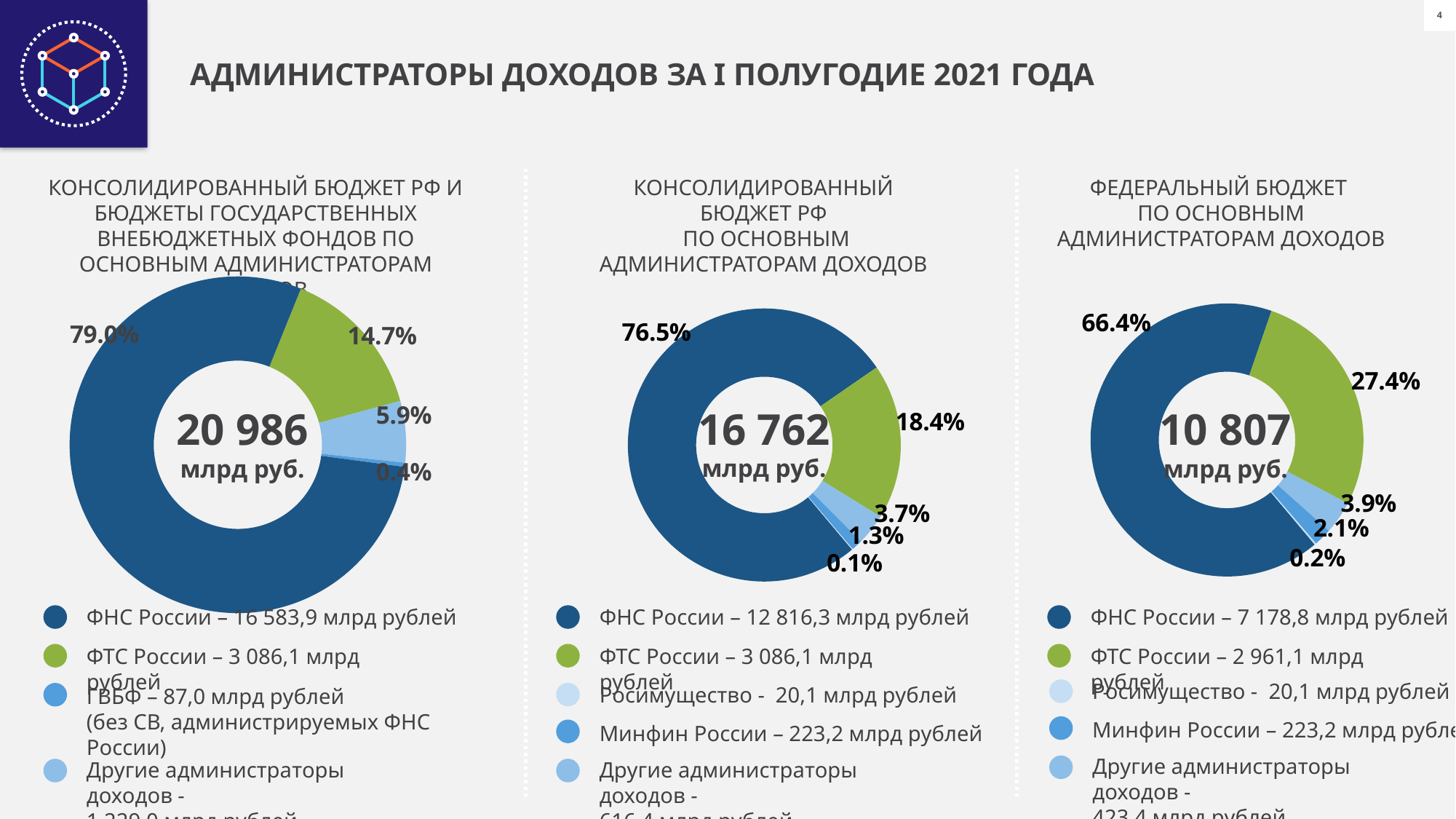
In the middle chart, how many slices does the donut have? 5 In the right chart, which administrator has the largest share? ФНС России In the left chart (консолидированный бюджет РФ и бюджеты государственных внебюджетных фондов), what share does ФНС России hold? 79.0% In the left chart, what total value is shown in the centre of the donut? 20 986 млрд руб. In the right chart, what total value is shown in the centre of the donut? 10 807 млрд руб. Is the ФТС России share larger in the middle chart or in the right chart? Right chart (27.4%) What kind of chart is used on this slide for each of the three budgets? Pie (donut) chart In the right chart (федеральный бюджет по основным администраторам доходов), what share does ФНС России hold? 66.4% In the left chart, what is the difference in percentage points between the ФНС России share (79.0%) and the ФТС России share (14.7%)? 64.3 percentage points In the middle chart (консолидированный бюджет РФ по основным администраторам доходов), what share does ФТС России hold? 18.4% In the left chart, how many slices does the donut have? 4 In the middle chart, what total value is shown in the centre of the donut? 16 762 млрд руб.